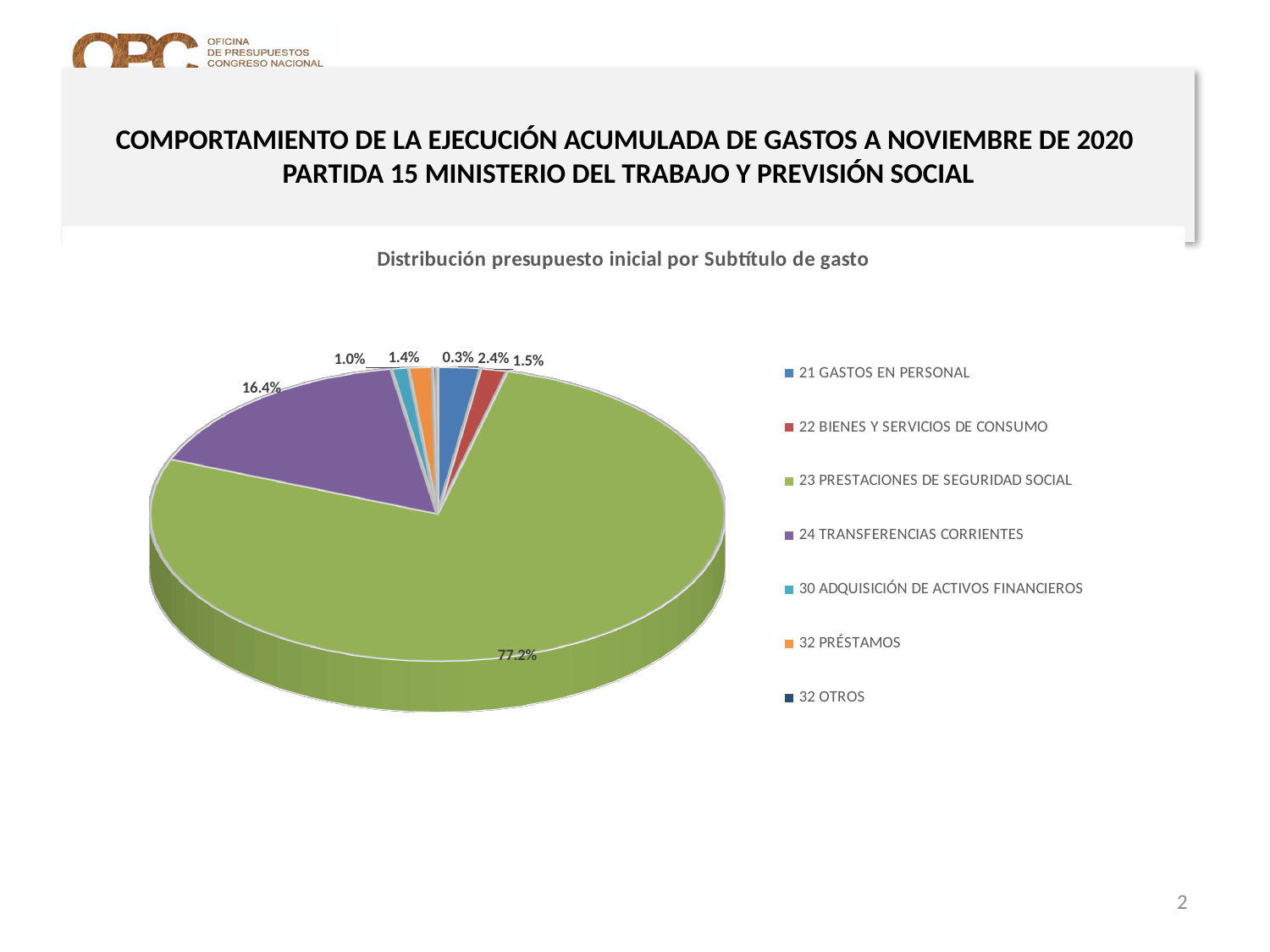
What colour is the slice for 24 TRANSFERENCIAS CORRIENTES? Purple Which category has the largest slice of the pie? 23 PRESTACIONES DE SEGURIDAD SOCIAL What type of chart is shown on the slide? Pie chart What is the difference in percentage points between the slices for 23 PRESTACIONES DE SEGURIDAD SOCIAL and 24 TRANSFERENCIAS CORRIENTES? 60.8 percentage points What share of the pie does 24 TRANSFERENCIAS CORRIENTES represent? 16.4% Which is larger, the slice for 23 PRESTACIONES DE SEGURIDAD SOCIAL or the slice for 24 TRANSFERENCIAS CORRIENTES? 23 PRESTACIONES DE SEGURIDAD SOCIAL What is the title of the chart? Distribución presupuesto inicial por Subtítulo de gasto What share of the pie does 21 GASTOS EN PERSONAL represent? 2.4% How many categories does the legend list? 7 What share of the pie does 23 PRESTACIONES DE SEGURIDAD SOCIAL represent? 77.2% What is the smallest percentage label shown on the pie? 0.3%